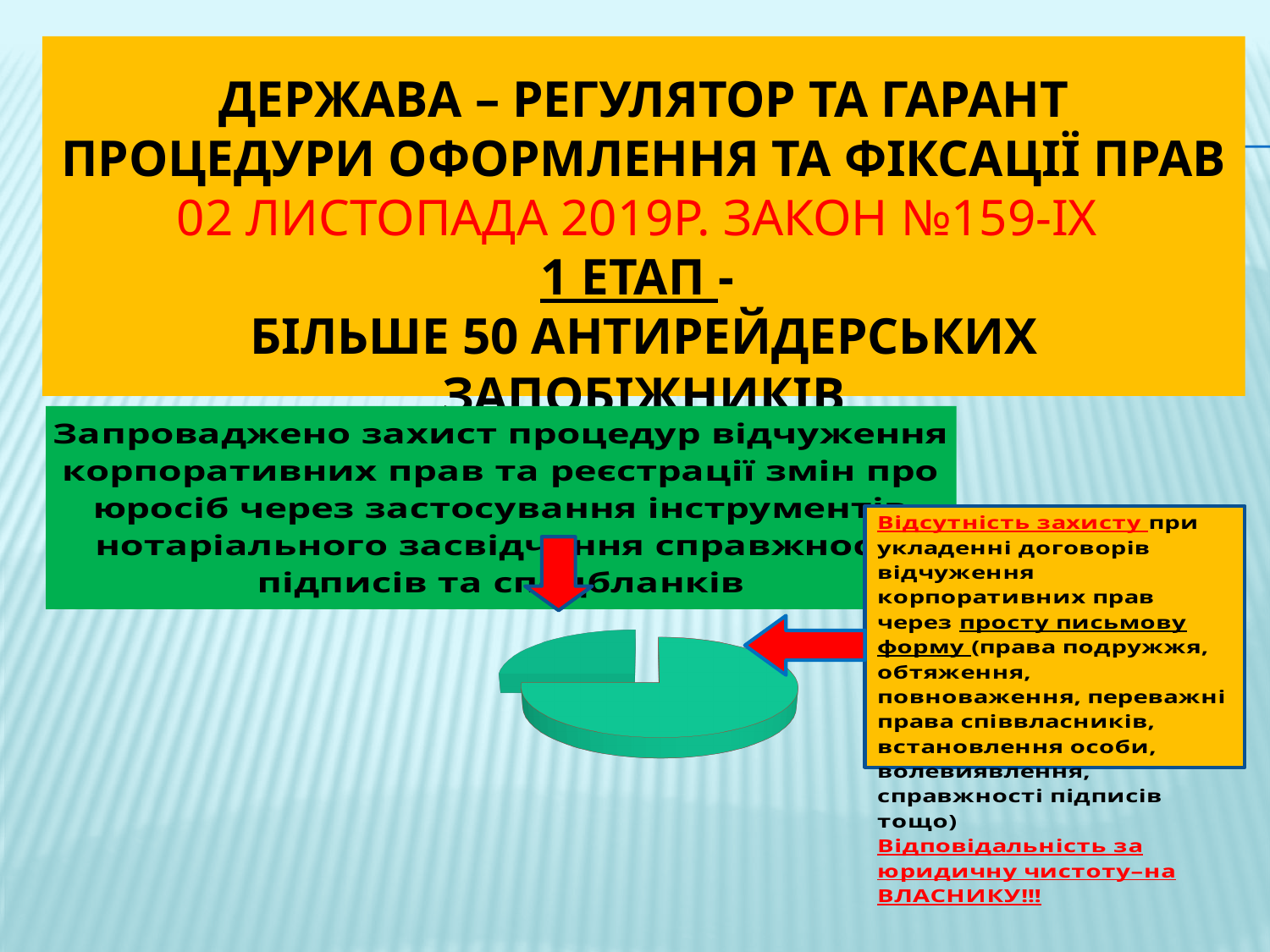
Does the pie chart display a legend? No How many slices does the pie chart have? 2 Does the pie chart show data labels with values on its slices? No What kind of chart is shown on the slide? pie chart Which slice of the pie chart is larger, the one on the left or the one on the right? the one on the right